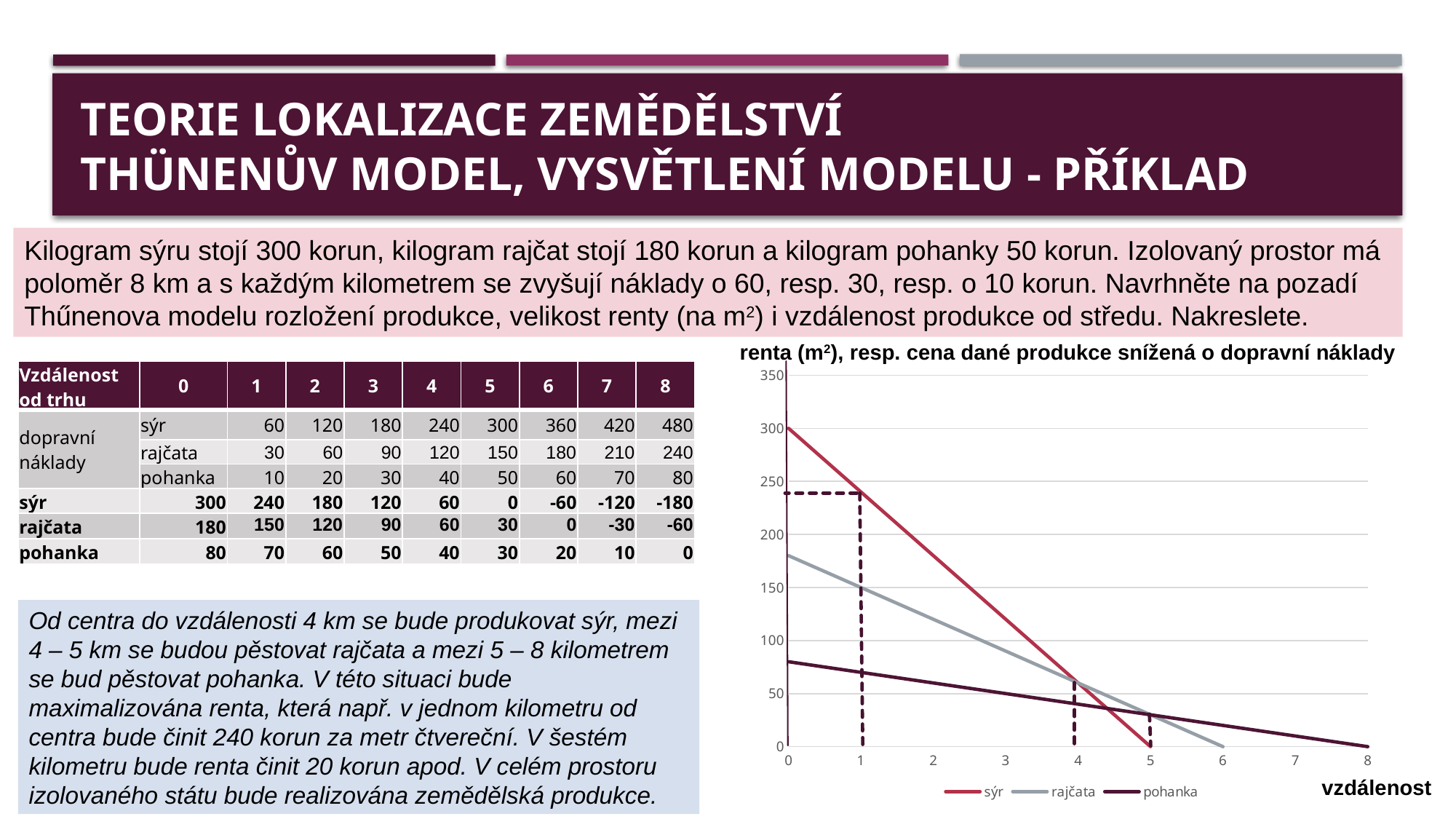
What is the value of the sýr line at distance 0? 300 Which series are listed in the chart legend? sýr, rajčata, pohanka How many series does the chart legend list? 3 Is the value of the pohanka line at distance 0 greater or less than 100? less At what distance does the sýr line reach 0? 5 Is the value of the rajčata line at distance 0 greater or less than 150? greater Which series has the highest value at distance 0? sýr Which series has the lowest value at distance 0? pohanka What kind of chart is shown on the slide? line chart At what distance does the rajčata line reach 0? 6 At what distance does the pohanka line reach 0? 8 Do the values of the sýr line rise or fall as distance increases? fall